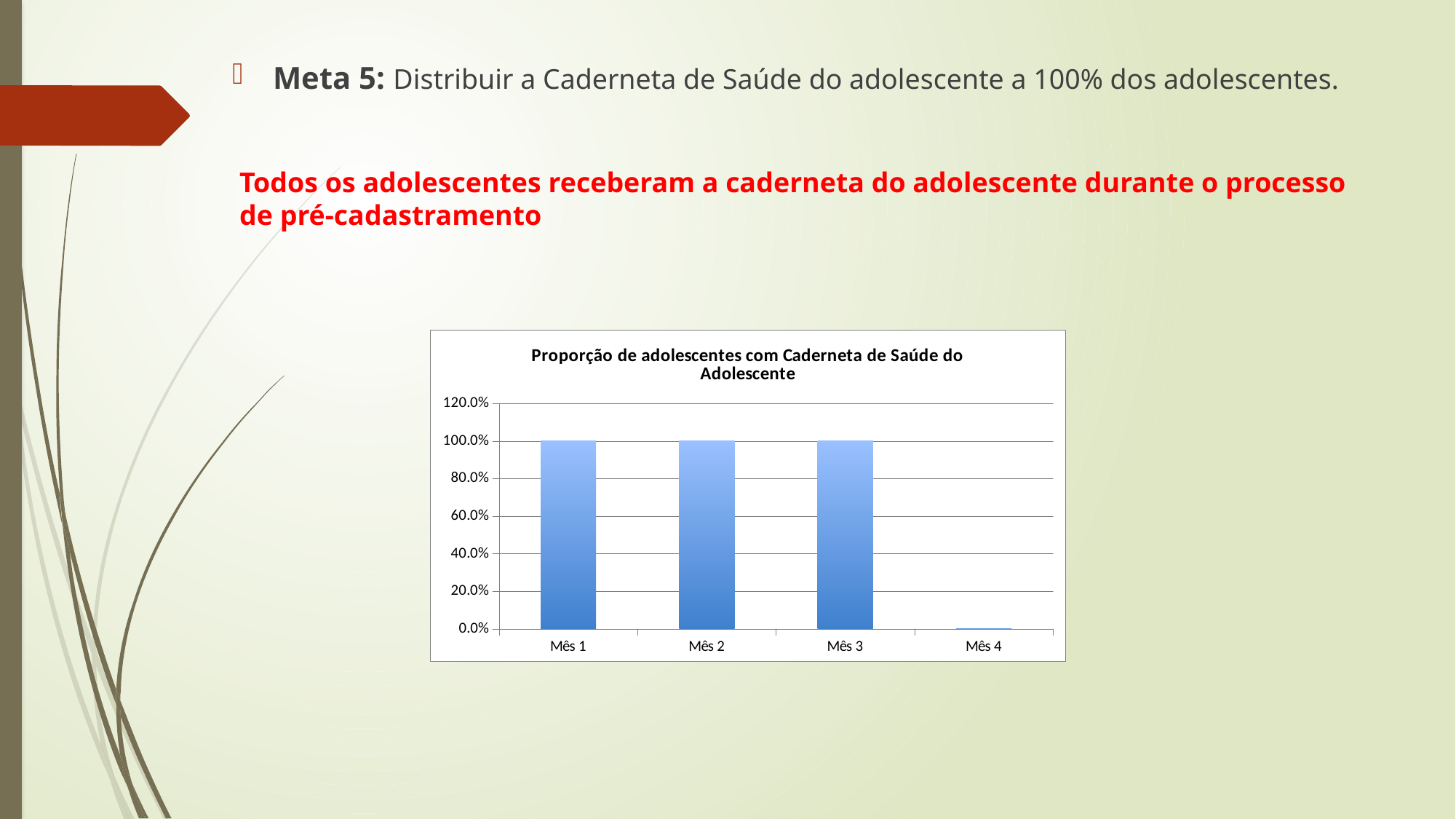
Is the value for Mês 4 greater or less than 20.0%? less Which is larger, the value for Mês 1 or the value for Mês 4? Mês 1 What is the title of the chart? Proporção de adolescentes com Caderneta de Saúde do Adolescente Is the value for Mês 2 greater or less than 80.0%? greater What is the value for Mês 3 in the chart? 100.0% What is the difference between the values for Mês 1 and Mês 3? 0.0% What kind of chart is shown on the slide? bar chart How many months are shown on the x axis of the chart? 4 What is the value for Mês 2 in the chart? 100.0% What is the value for Mês 1 in the chart? 100.0% Which month has the lowest value in the chart? Mês 4 Do the values rise or fall from Mês 3 to Mês 4? fall